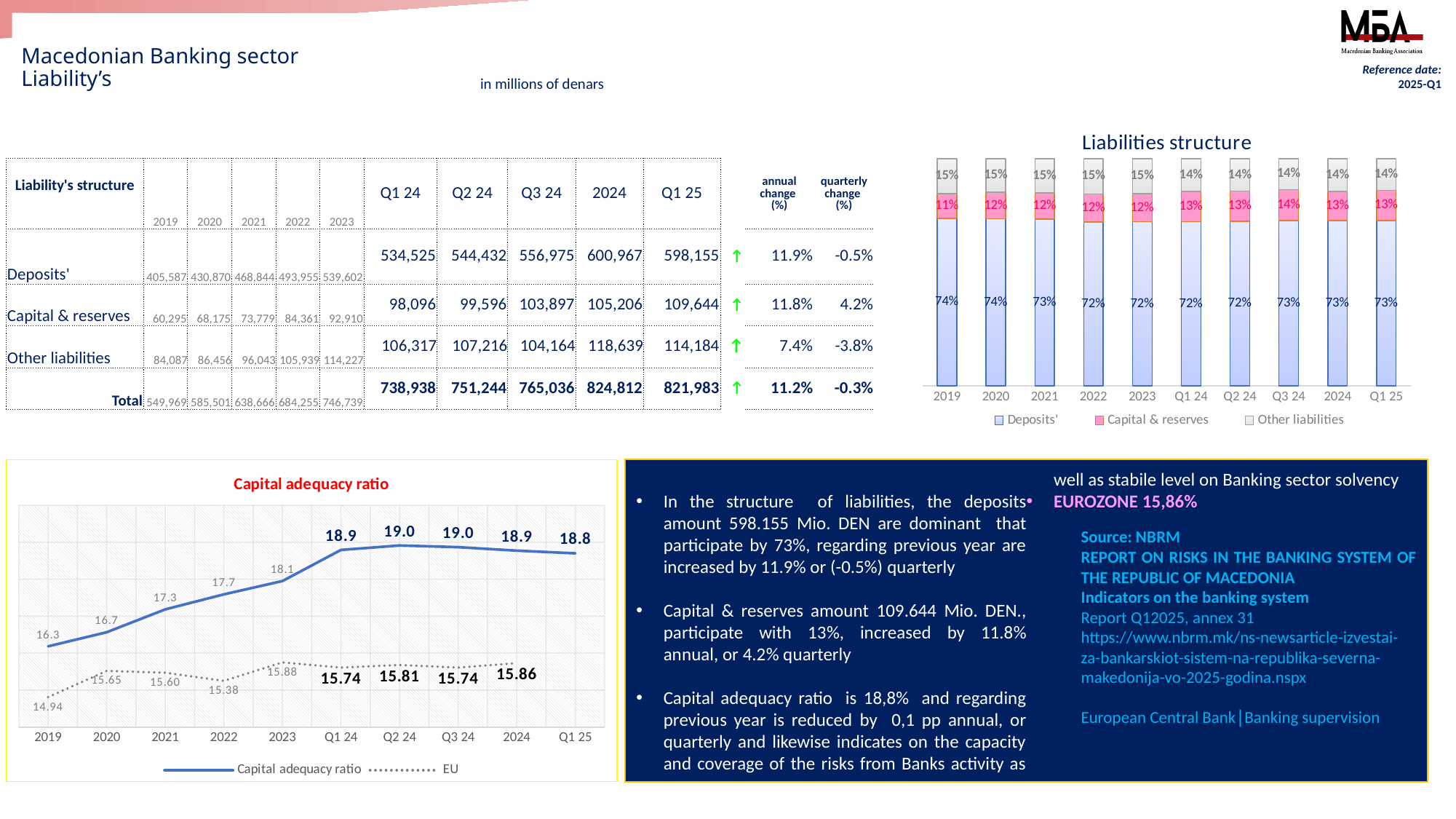
In the Capital adequacy ratio chart, what is the EU value for 2019? 14.94 In the Liabilities structure chart, what share do Capital & reserves have in Q3 24? 14% In the Capital adequacy ratio chart, which period has the lowest Capital adequacy ratio value? 2019 In the Liabilities structure chart, how many series does the legend list? 3 In the Capital adequacy ratio chart, does the Capital adequacy ratio rise or fall from 2019 to 2023? Rise In the Liabilities structure chart, what share do Deposits' have in Q1 25? 73% What kind of chart is the Liabilities structure chart? Stacked bar chart In the Capital adequacy ratio chart, what is the Capital adequacy ratio value for Q1 25? 18.8 In the Liabilities structure chart, what share do Other liabilities have in 2019? 15% In the Liabilities structure chart, how many periods are shown on the x axis? 10 In the Capital adequacy ratio chart, which is larger in 2023: the Capital adequacy ratio or the EU value? Capital adequacy ratio In the Capital adequacy ratio chart, what is the difference between the Capital adequacy ratio and the EU value in 2024? 3.04